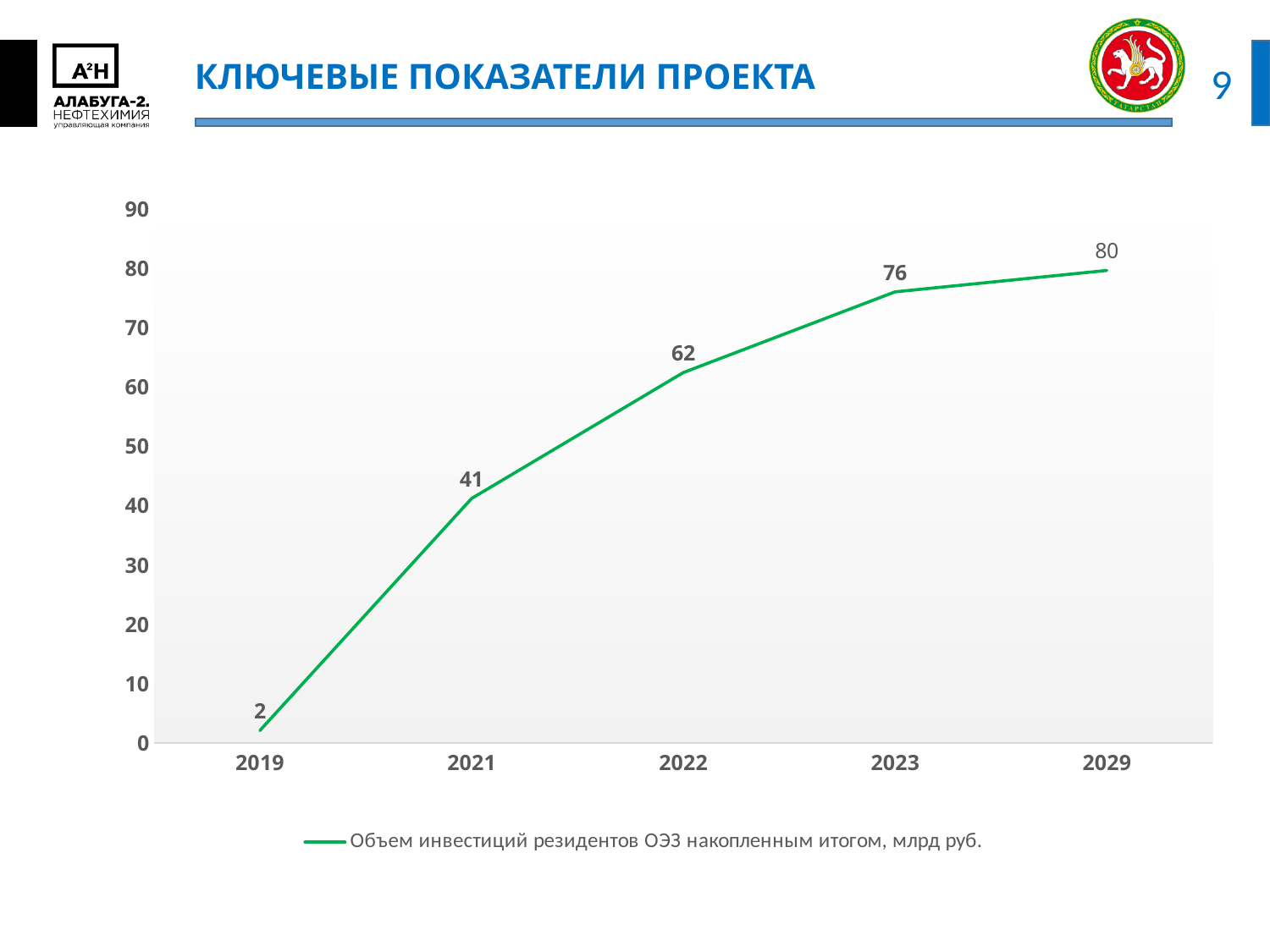
Which is larger, the value for 2022 or the value for 2023? 2023 How many years are plotted on the x axis? 5 How many series does the legend list? 1 Which year has the lowest value? 2019 What is the value for 2029? 80 What is the difference between the values for 2022 and 2021? 21 What kind of chart is shown? line chart Do the values rise or fall from 2019 to 2029? rise What is the value for 2019? 2 Which year has the highest value? 2029 What is the value for 2023? 76 What is the value for 2021? 41